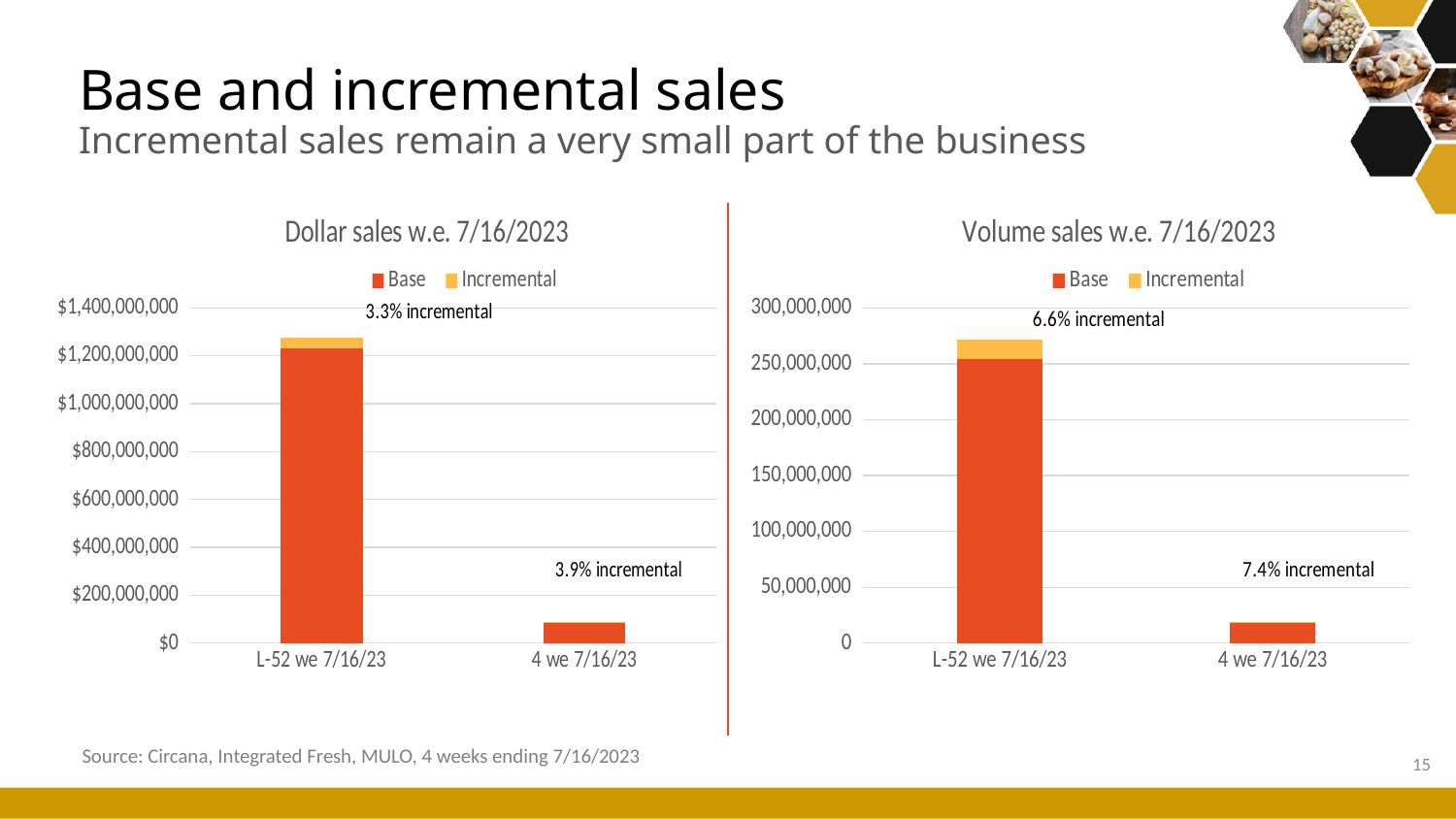
In the 'Dollar sales w.e. 7/16/2023' chart, which category has the taller bar? L-52 we 7/16/23 In the 'Dollar sales w.e. 7/16/2023' chart, is the total bar for L-52 we 7/16/23 greater or less than $1,000,000,000? greater In the 'Volume sales w.e. 7/16/2023' chart, is the total bar for L-52 we 7/16/23 greater or less than 200,000,000? greater What kind of chart is the 'Dollar sales w.e. 7/16/2023' chart? Stacked bar chart How many series does the legend of the 'Volume sales w.e. 7/16/2023' chart list? 2 In the 'Volume sales w.e. 7/16/2023' chart, which series is shown in orange-red? Base In the 'Volume sales w.e. 7/16/2023' chart, what percentage is labelled as incremental for 4 we 7/16/23? 7.4% incremental In the 'Dollar sales w.e. 7/16/2023' chart, is the bar for 4 we 7/16/23 greater or less than $200,000,000? less In the 'Dollar sales w.e. 7/16/2023' chart, how many categories are shown on the x axis? 2 In the 'Dollar sales w.e. 7/16/2023' chart, what percentage of sales is labelled as incremental for L-52 we 7/16/23? 3.3% incremental In the 'Volume sales w.e. 7/16/2023' chart, what percentage is labelled as incremental for L-52 we 7/16/23? 6.6% incremental In the 'Dollar sales w.e. 7/16/2023' chart, what percentage of sales is labelled as incremental for 4 we 7/16/23? 3.9% incremental